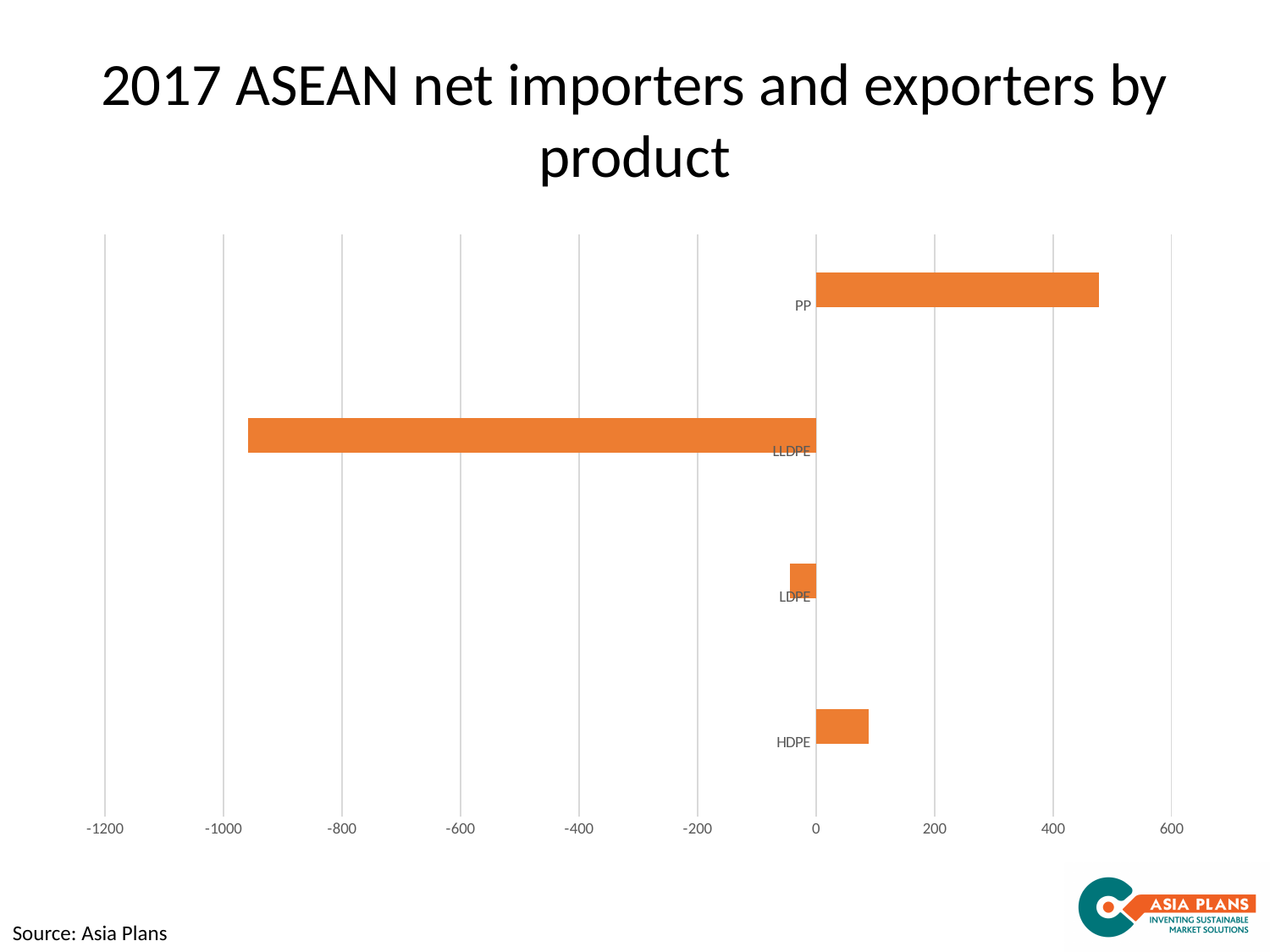
What kind of chart is shown on the slide? bar chart Is the value for HDPE greater or less than 200? less Is the value for LLDPE greater or less than -800? less Which product has the highest value in the chart? PP What source is cited for the chart? Asia Plans Is the value for PP greater or less than 400? greater Which has the larger value, LDPE or LLDPE? LDPE What is the title of the chart on the slide? 2017 ASEAN net importers and exporters by product How many product categories are plotted in the chart? 4 Which has the larger value, HDPE or PP? PP Which product has the lowest value in the chart? LLDPE